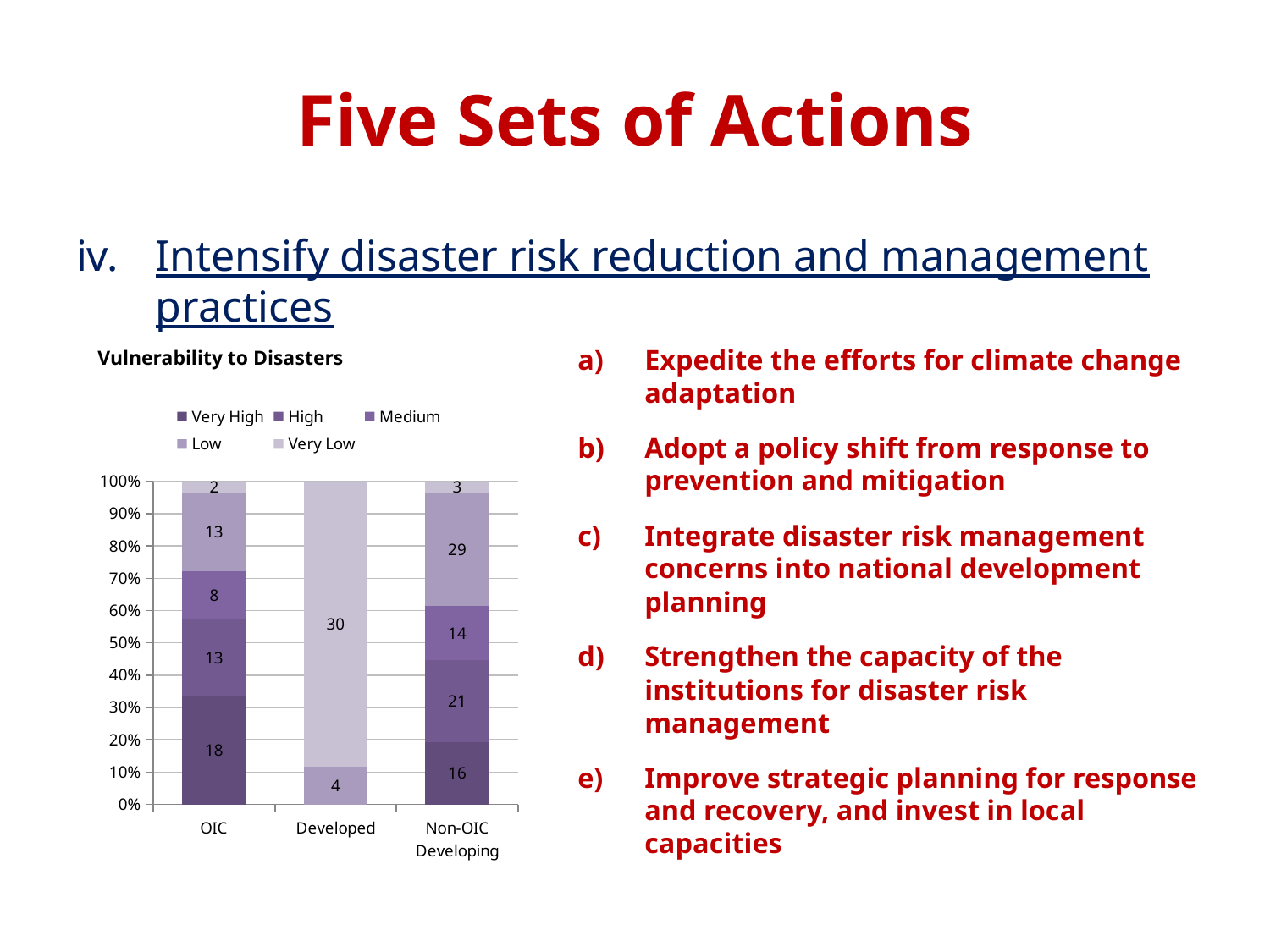
How many categories are shown on the x axis of the chart? 3 How many series does the chart legend list? 5 What type of chart is shown on the slide? Stacked bar chart What is the High value for Non-OIC Developing? 21 What is the Very High value for OIC? 18 What is the title of the chart? Vulnerability to Disasters What is the Very Low value for OIC? 2 What is the total of the stacked bar for Non-OIC Developing? 83 What is the Low value for Non-OIC Developing? 29 Which is larger, the High value for OIC or the High value for Non-OIC Developing? Non-OIC Developing What is the total of the stacked bar for OIC? 54 What is the difference between the Very High value for OIC and the Very High value for Non-OIC Developing? 2